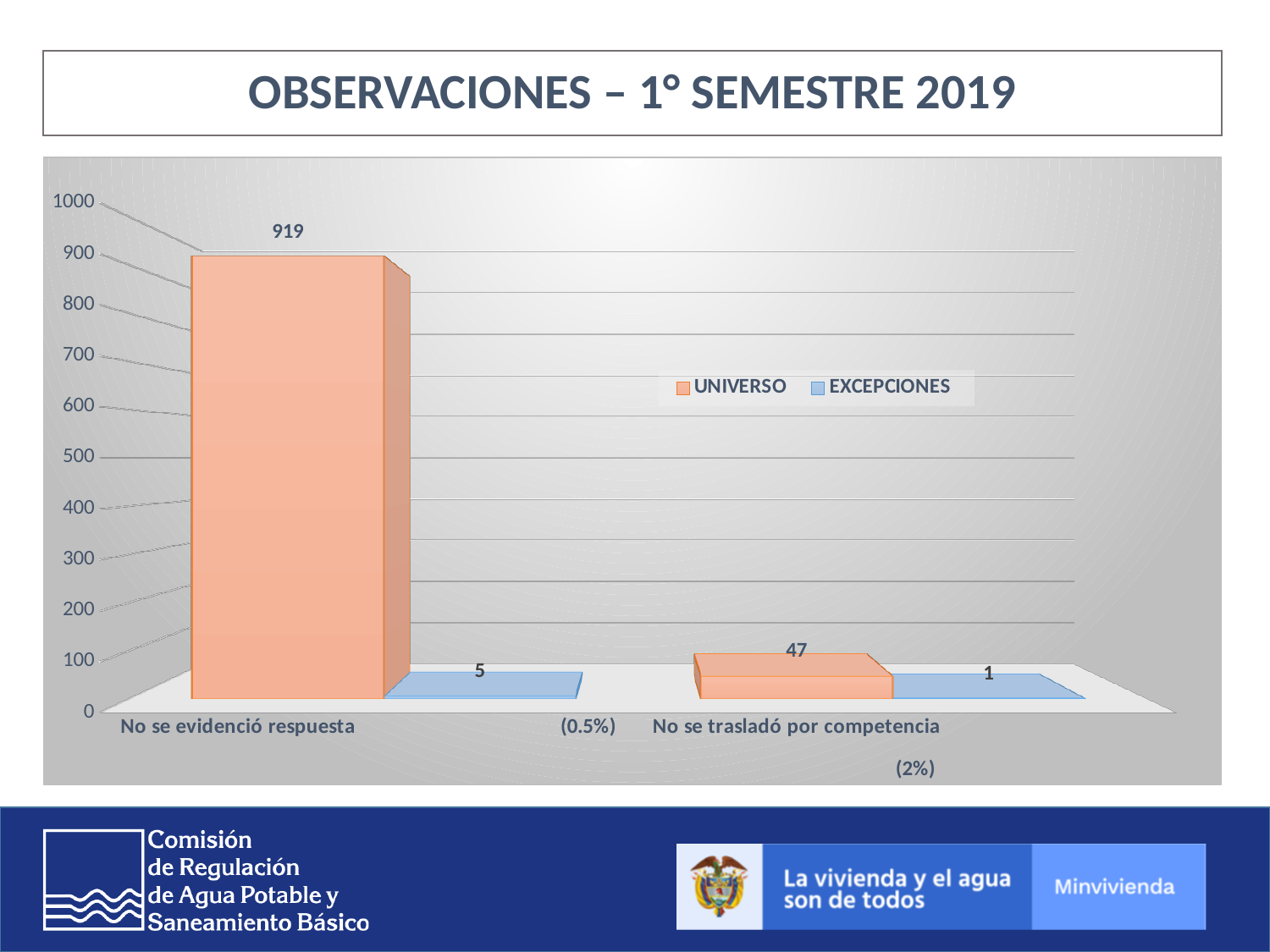
What is the UNIVERSO value for 'No se trasladó por competencia'? 47 What is the UNIVERSO value for 'No se evidenció respuesta'? 919 Which is larger: the UNIVERSO value for 'No se trasladó por competencia' or the EXCEPCIONES value for 'No se evidenció respuesta'? UNIVERSO for No se trasladó por competencia Which category has the lowest EXCEPCIONES value? No se trasladó por competencia What is the difference between the UNIVERSO values for 'No se evidenció respuesta' and 'No se trasladó por competencia'? 872 What is the EXCEPCIONES value for 'No se trasladó por competencia'? 1 Is the UNIVERSO value for 'No se evidenció respuesta' greater or less than 900? greater Which category has the highest UNIVERSO value? No se evidenció respuesta What is the title of the slide? OBSERVACIONES – 1° SEMESTRE 2019 What is the EXCEPCIONES value for 'No se evidenció respuesta'? 5 How many series does the legend list? 2 What kind of chart is shown on the slide? Bar chart